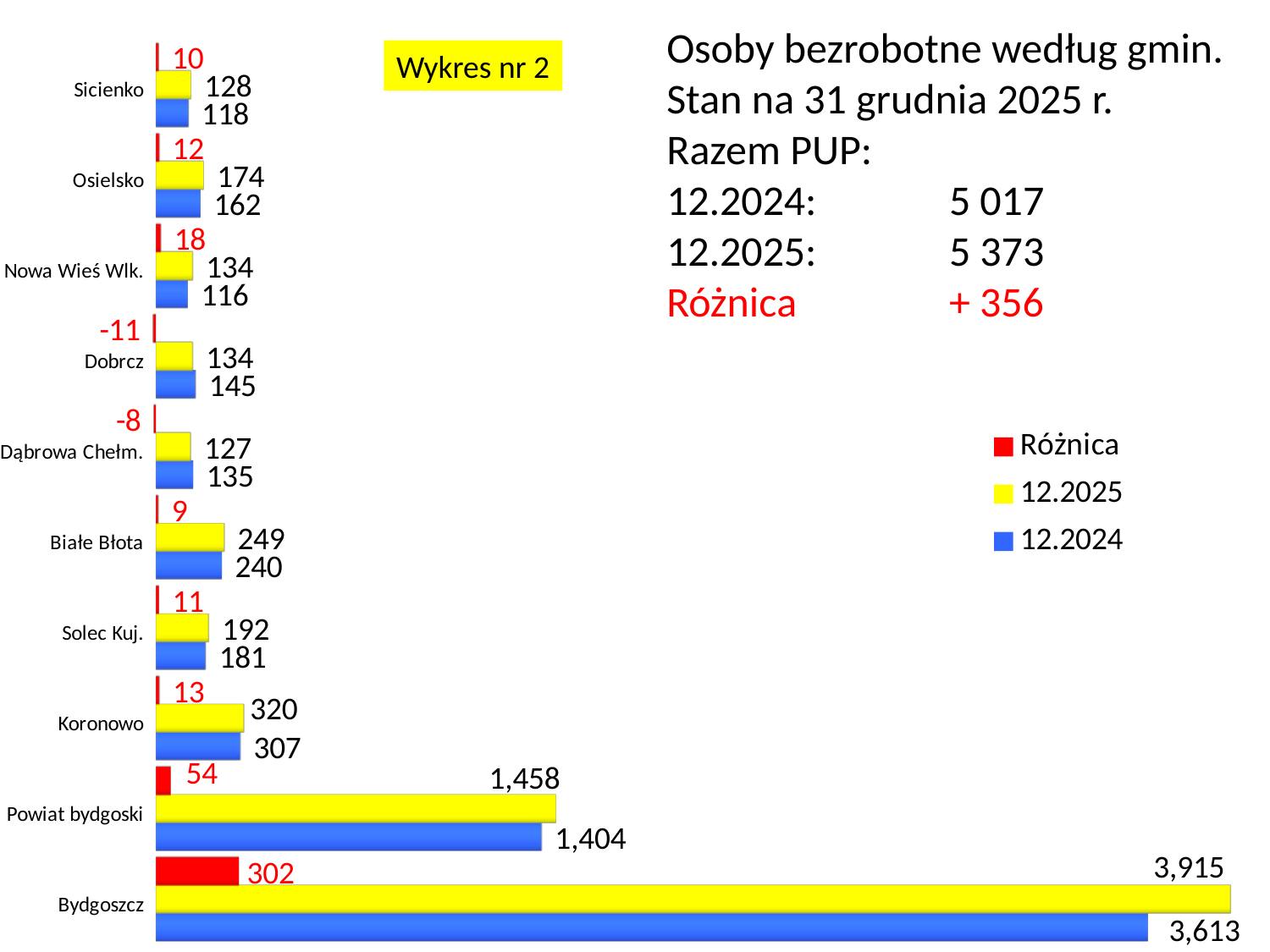
Which category has the lowest 12.2024 value? Nowa Wieś Wlk. Which category has the highest 12.2024 value? Bydgoszcz How many series does the legend list? 3 What kind of chart is shown on the slide? bar chart What is the Różnica value for Powiat bydgoski? 54 What is the 12.2025 value for Bydgoszcz? 3,915 Which colour represents the 12.2025 series in the legend? yellow What is the 12.2025 value for Dobrcz? 134 What is the difference between the 12.2025 and 12.2024 values for Białe Błota? 9 What is the 12.2024 value for Koronowo? 307 How many categories (gminy) are shown on the chart? 10 Which is larger for Dąbrowa Chełm., the 12.2025 value or the 12.2024 value? 12.2024